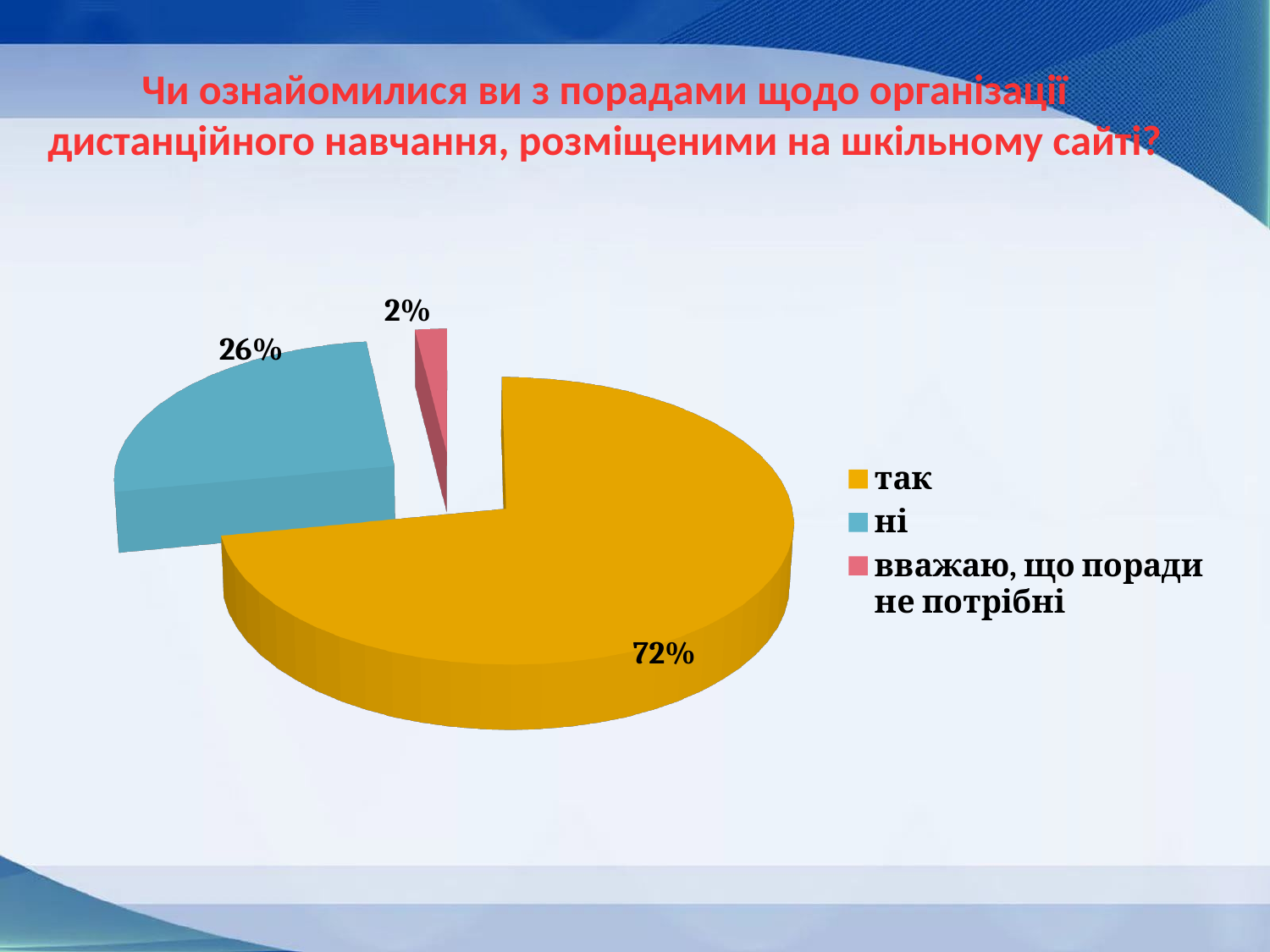
What is the difference in percentage points between "ні" and "вважаю, що поради не потрібні"? 24 What share of the pie does "так" represent? 72% What colour is the slice for "так"? yellow What share of the pie does "ні" represent? 26% How many categories does the pie chart show? 3 What share of the pie does "вважаю, що поради не потрібні" represent? 2% Which category has the smallest slice of the pie? вважаю, що поради не потрібні Which category has the largest slice of the pie? так What kind of chart is shown on the slide? pie chart Which is larger, the share for "ні" or the share for "вважаю, що поради не потрібні"? ні What is the difference in percentage points between "так" and "ні"? 46 What colour is the slice for "ні"? blue